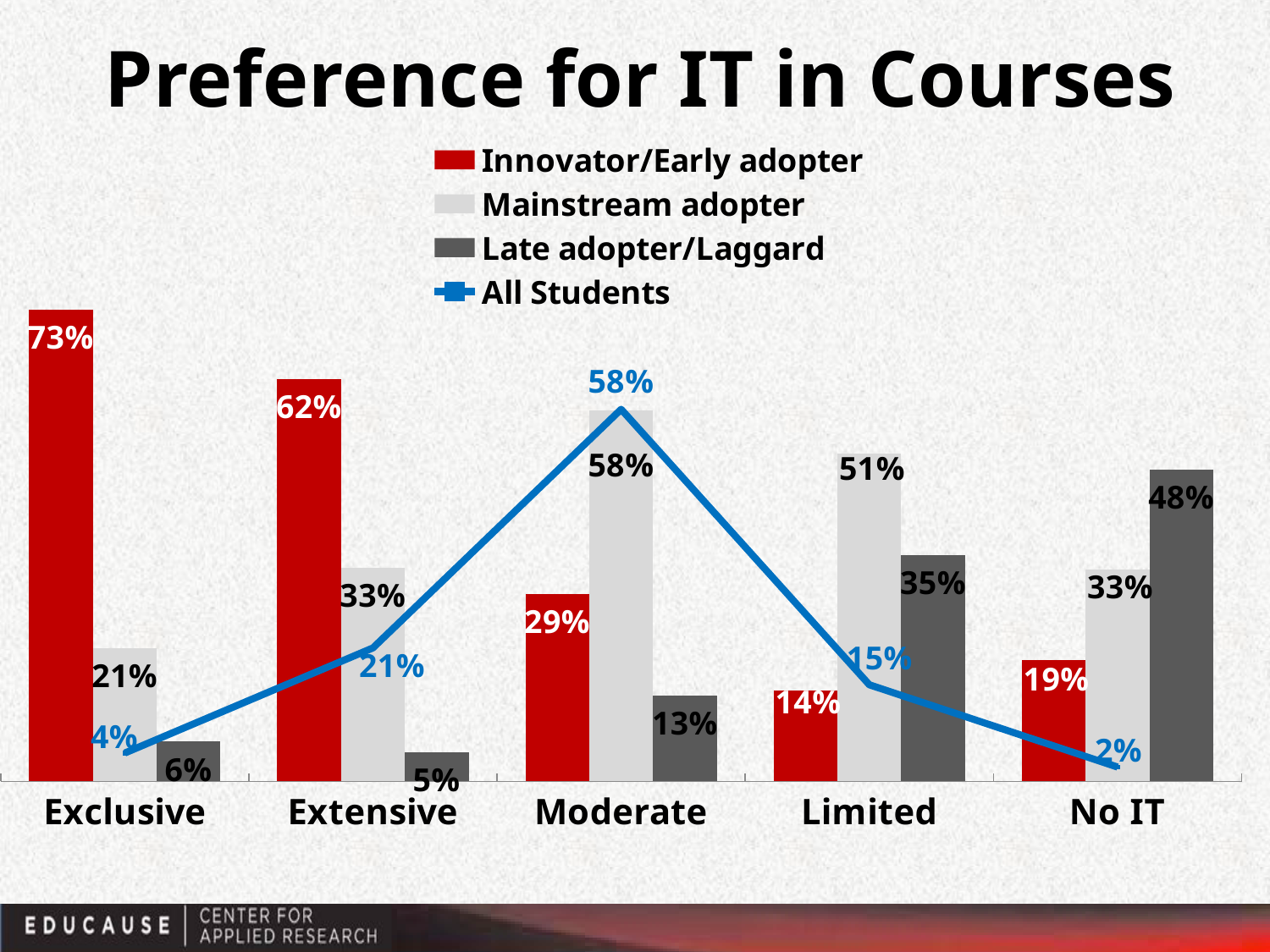
What is the difference between the Innovator/Early adopter and Mainstream adopter values in the Extensive category? 29% How many categories are shown on the x axis? 5 In which category is the Innovator/Early adopter value highest? Exclusive What is the value for Mainstream adopter in the Limited category? 51% What is the value for Late adopter/Laggard in the No IT category? 48% How many series does the legend list? 4 In the Moderate category, which is larger: the Innovator/Early adopter value or the Mainstream adopter value? Mainstream adopter What is the All Students value for the Moderate category? 58% What is the value for Innovator/Early adopter in the Exclusive category? 73% Which series is plotted as a line rather than bars? All Students In which category is the All Students value lowest? No IT What is the title of the chart? Preference for IT in Courses